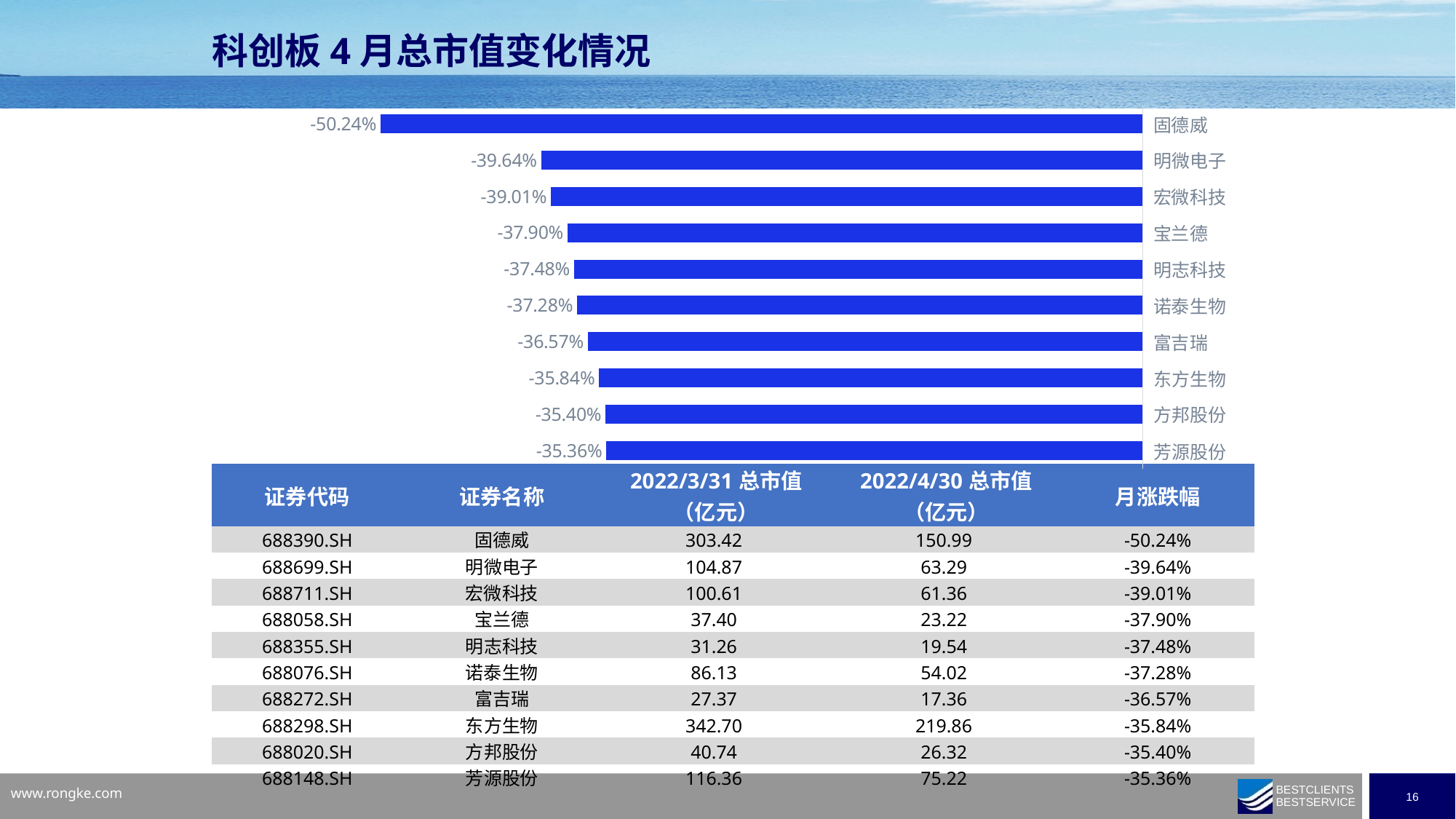
What type of chart is shown on the slide? Bar chart Which company has the largest decline (lowest value) in the bar chart? 固德威 What is the difference in percentage points between the values for 宝兰德 and 明志科技? 0.42 percentage points What is the value shown for 宏微科技 in the bar chart? -39.01% Which company has the smallest decline (highest value) in the bar chart? 芳源股份 What is the title of the slide? 科创板 4 月总市值变化情况 How many companies are shown in the bar chart? 10 What is the difference in percentage points between the values for 固德威 and 明微电子? 10.60 percentage points What is the value shown for 固德威 in the bar chart? -50.24% What is the value shown for 芳源股份 in the bar chart? -35.36% What is the value shown for 东方生物 in the bar chart? -35.84% Which has a larger decline, 诺泰生物 or 富吉瑞? 诺泰生物